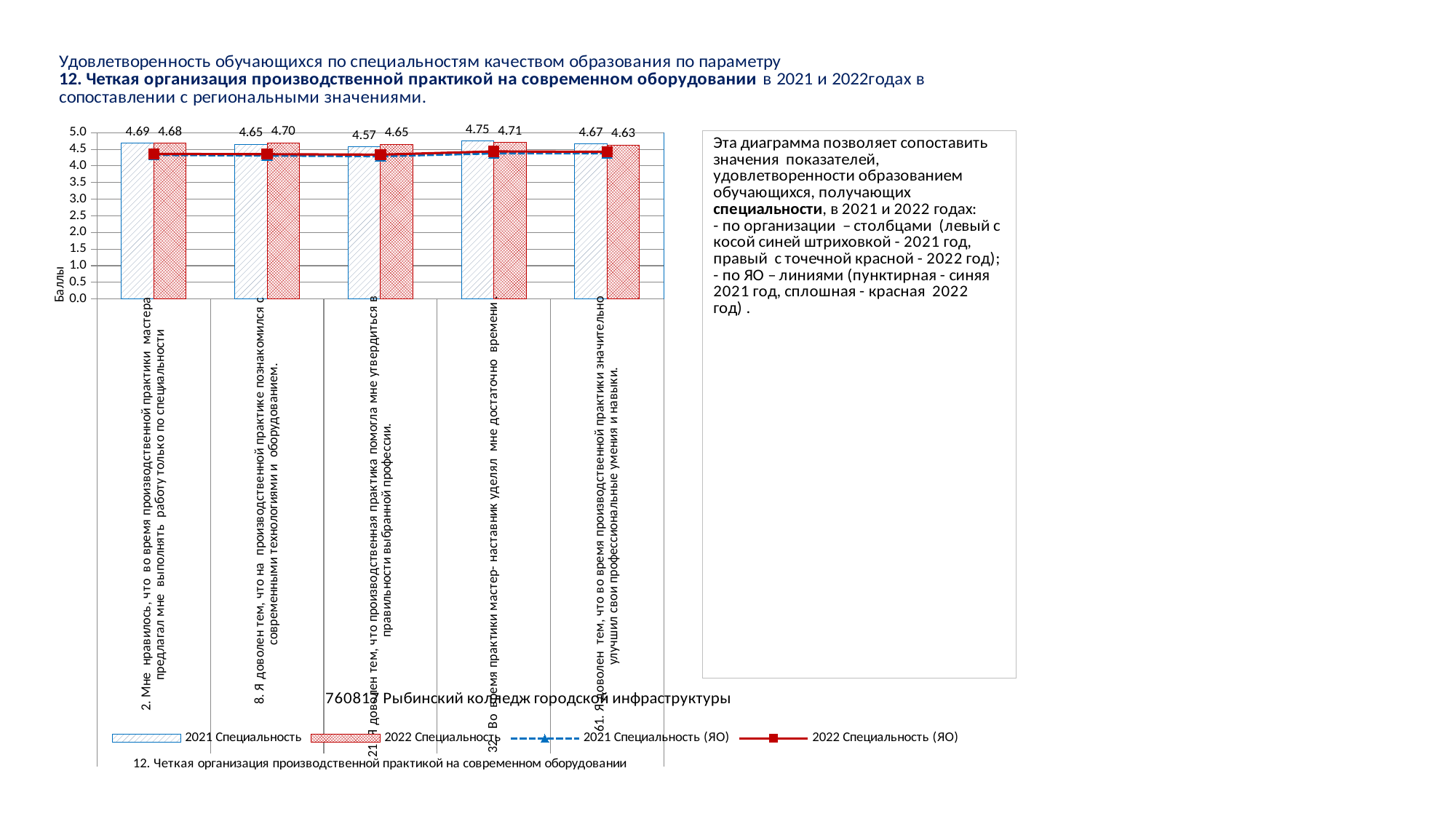
Which category has the lowest 2021 Специальность value? 21. Я доволен тем, что производственная практика помогла мне утвердиться в правильности выбранной профессии (4.57) How many series does the legend list? 4 What is the value of the 2022 Специальность bar for item 21 (производственная практика помогла мне утвердиться в правильности выбранной профессии)? 4.65 For item 21, what is the difference between the 2022 Специальность value and the 2021 Специальность value? 0.08 What is the title of the vertical axis? Баллы Which category has the highest 2021 Специальность value? 32. Во время практики мастер-наставник уделял мне достаточно времени (4.75) For item 8, which is larger: the 2021 Специальность value or the 2022 Специальность value? 2022 Специальность (4.70) What is the value of the 2022 Специальность bar for item 8 (познакомился с современными технологиями и оборудованием)? 4.70 Which category has the lowest 2022 Специальность value? 61. Я доволен тем, что во время производственной практики значительно улучшил свои профессиональные умения и навыки (4.63) Is the 2021 Специальность (ЯО) line value for item 2 greater or less than 4.0? greater How many categories (survey items) are shown on the x axis? 5 What is the value of the 2021 Специальность bar for item 32 (Во время практики мастер-наставник уделял мне достаточно времени)? 4.75